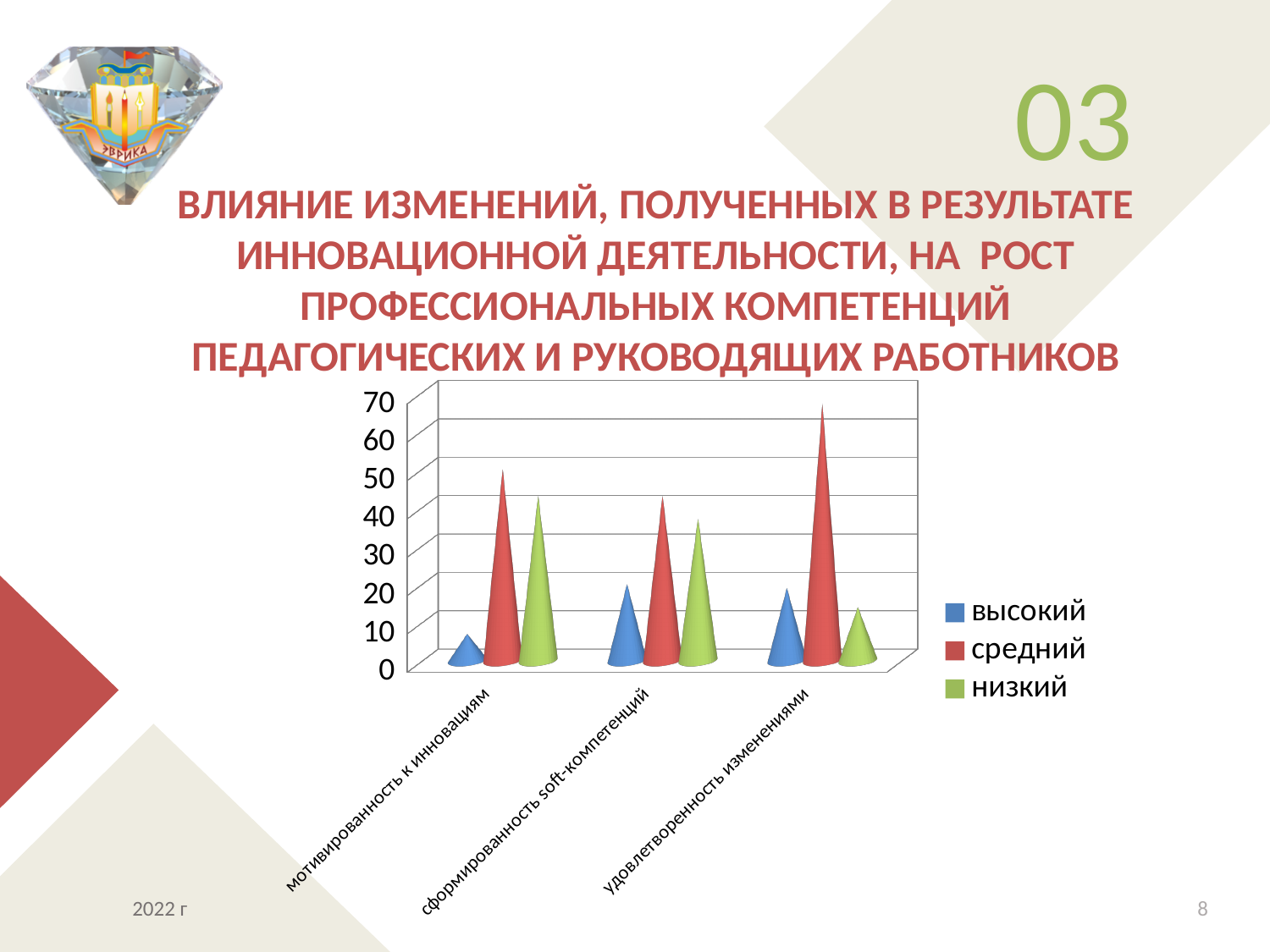
Which series has the highest value for the category "удовлетворенность изменениями"? средний Which is larger: the "низкий" value for "мотивированность к инновациям" or the "низкий" value for "удовлетворенность изменениями"? мотивированность к инновациям Is the "низкий" value for "удовлетворенность изменениями" greater or less than 20? less What kind of chart is shown on the slide? bar chart Is the "средний" value for "удовлетворенность изменениями" greater or less than 60? greater Is the "средний" value for "мотивированность к инновациям" greater or less than 40? greater How many categories are shown on the x axis of the chart? 3 How many series does the chart legend list? 3 What colour represents the "средний" series in the chart legend? red Which series has the lowest value for the category "мотивированность к инновациям"? высокий For which category is the "средний" series highest? удовлетворенность изменениями